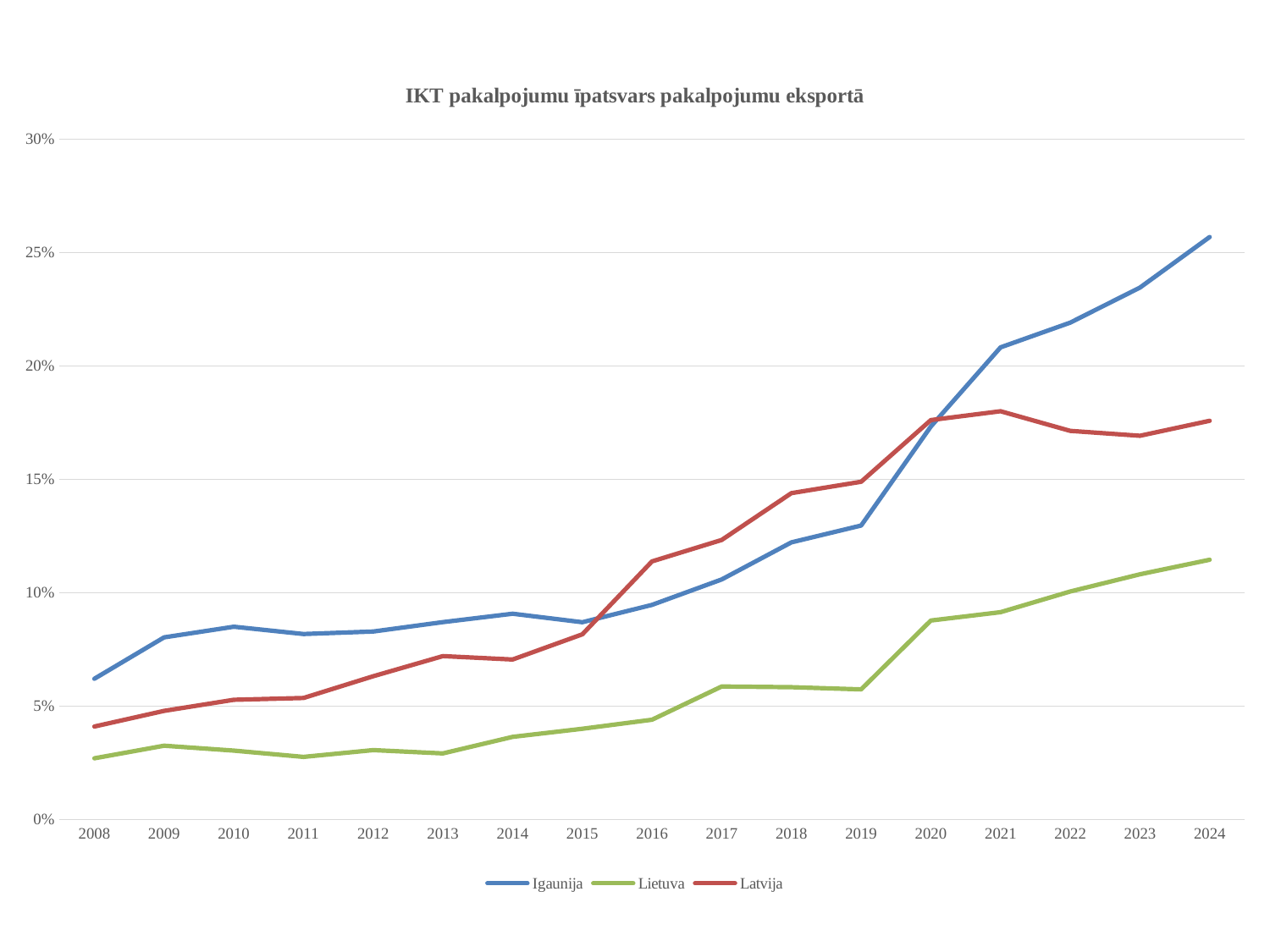
Is the value for Latvija in 2024 greater or less than 15%? greater How many years are shown on the x axis? 17 Which series is drawn in red? Latvija Is the value for Lietuva in 2008 greater or less than 5%? less Is the value for Igaunija in 2024 greater or less than 25%? greater What kind of chart is shown on the slide? line chart How many series does the legend list? 3 What is the title of the chart? IKT pakalpojumu īpatsvars pakalpojumu eksportā Which series has the lowest value in 2024? Lietuva Which series has the highest value in 2024? Igaunija In 2016, which is larger: the value for Latvija or the value for Igaunija? Latvija